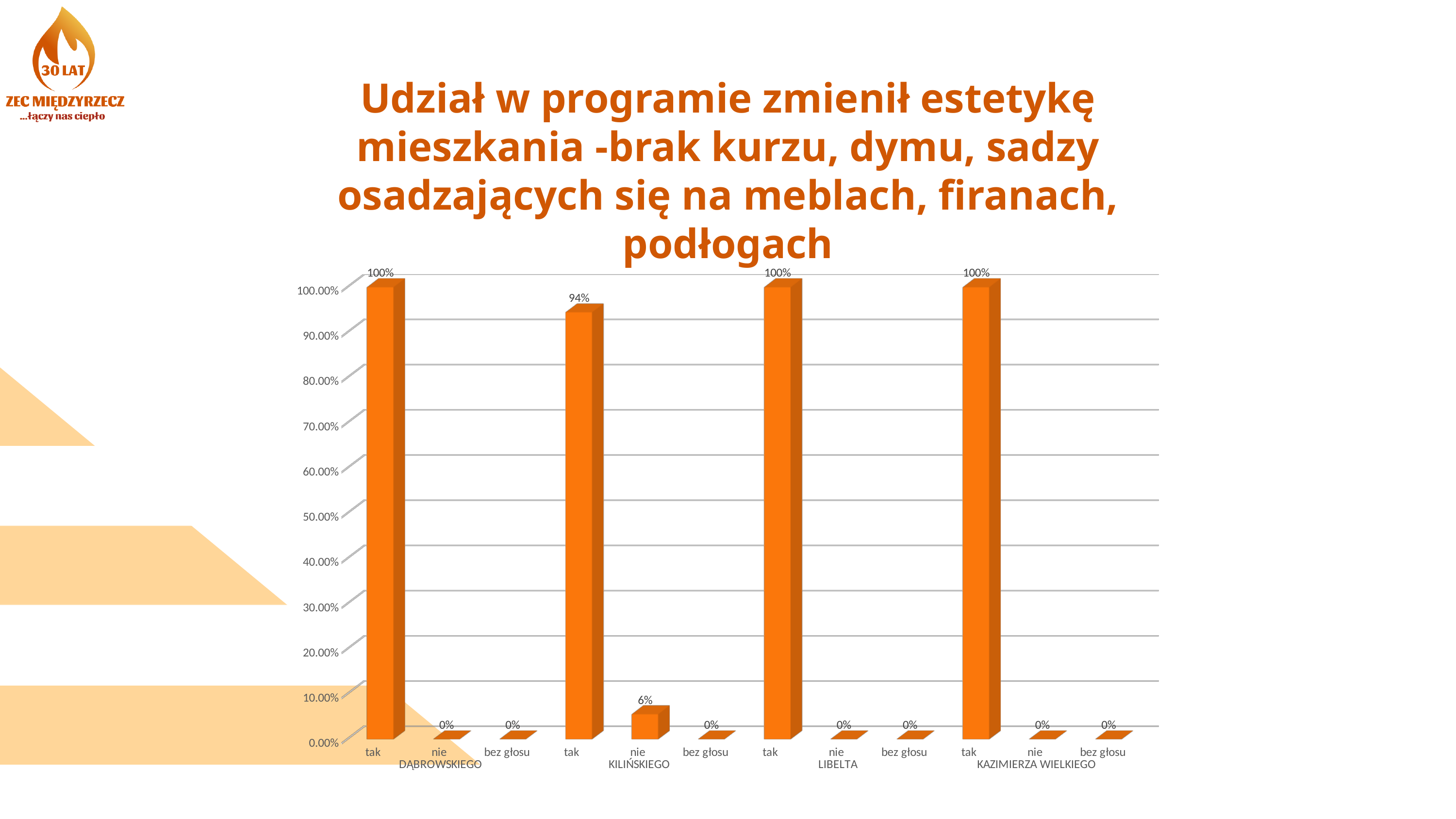
What kind of chart is shown on the slide? bar chart What is the difference between the "tak" and "nie" values in the KILIŃSKIEGO group? 88% Is the value for "tak" in the KILIŃSKIEGO group greater or less than 90.00%? greater Which group has the lowest value for "tak"? KILIŃSKIEGO How many street groups are shown on the x axis? 4 What is the value for "tak" in the KAZIMIERZA WIELKIEGO group? 100% What is the value for "nie" in the KILIŃSKIEGO group? 6% What is the value for "tak" in the KILIŃSKIEGO group? 94% Which is larger: "tak" for KILIŃSKIEGO or "tak" for LIBELTA? tak for LIBELTA What is the value for "tak" in the DĄBROWSKIEGO group? 100% How many bars in total are plotted on the chart? 12 What is the value for "bez głosu" in the LIBELTA group? 0%